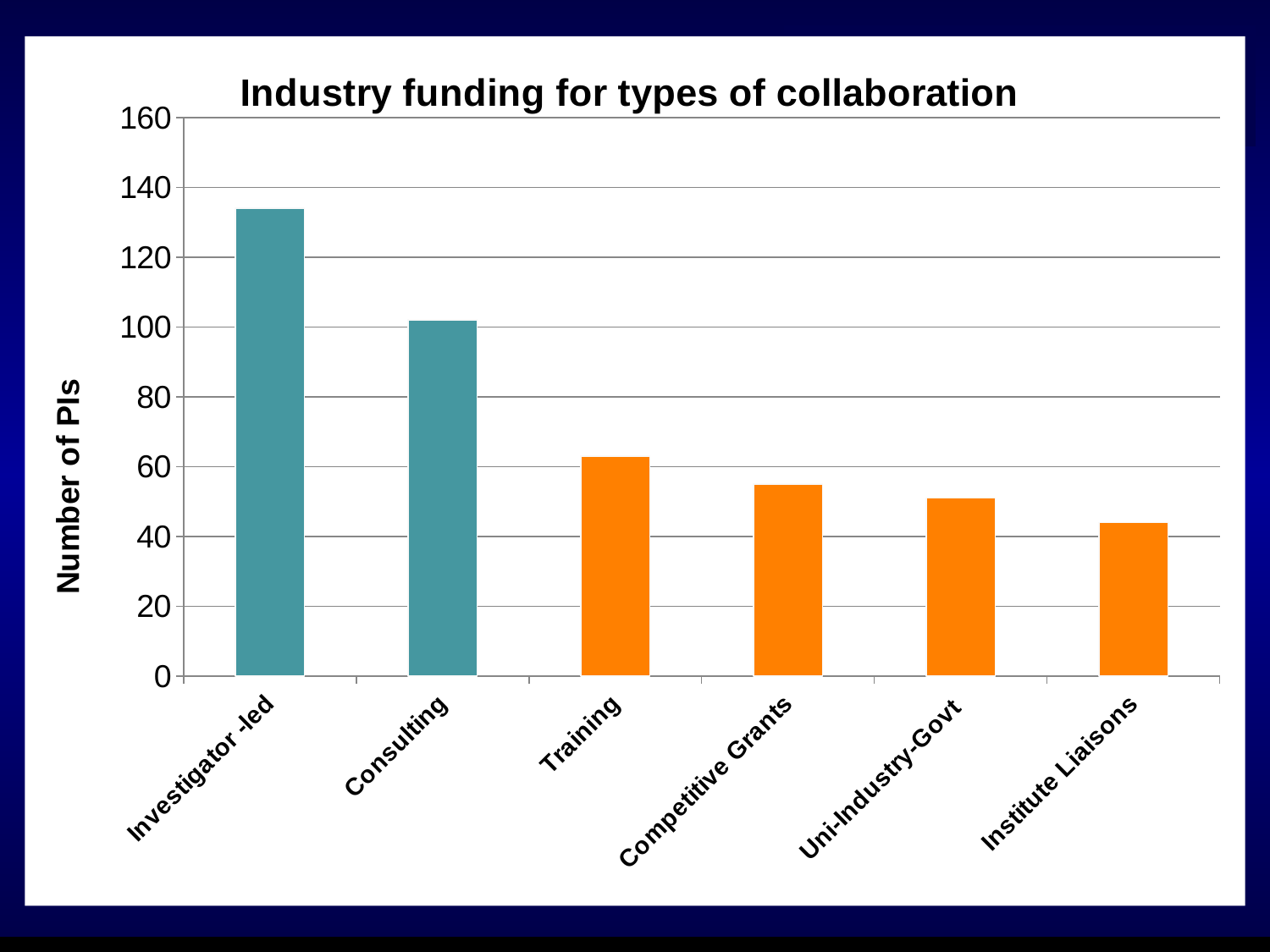
Is the value for Consulting greater or less than 120? less Which has more PIs, Consulting or Training? Consulting Do the values rise or fall moving from left to right along the x axis? fall Is the value for Institute Liaisons greater or less than 60? less What type of chart is shown on the slide? bar chart Which type of collaboration has the lowest number of PIs? Institute Liaisons Which type of collaboration has the highest number of PIs? Investigator -led What is the title of the chart? Industry funding for types of collaboration How many types of collaboration are shown on the x axis? 6 Is the value for Investigator -led greater or less than 120? greater What is the label on the vertical axis of the chart? Number of PIs